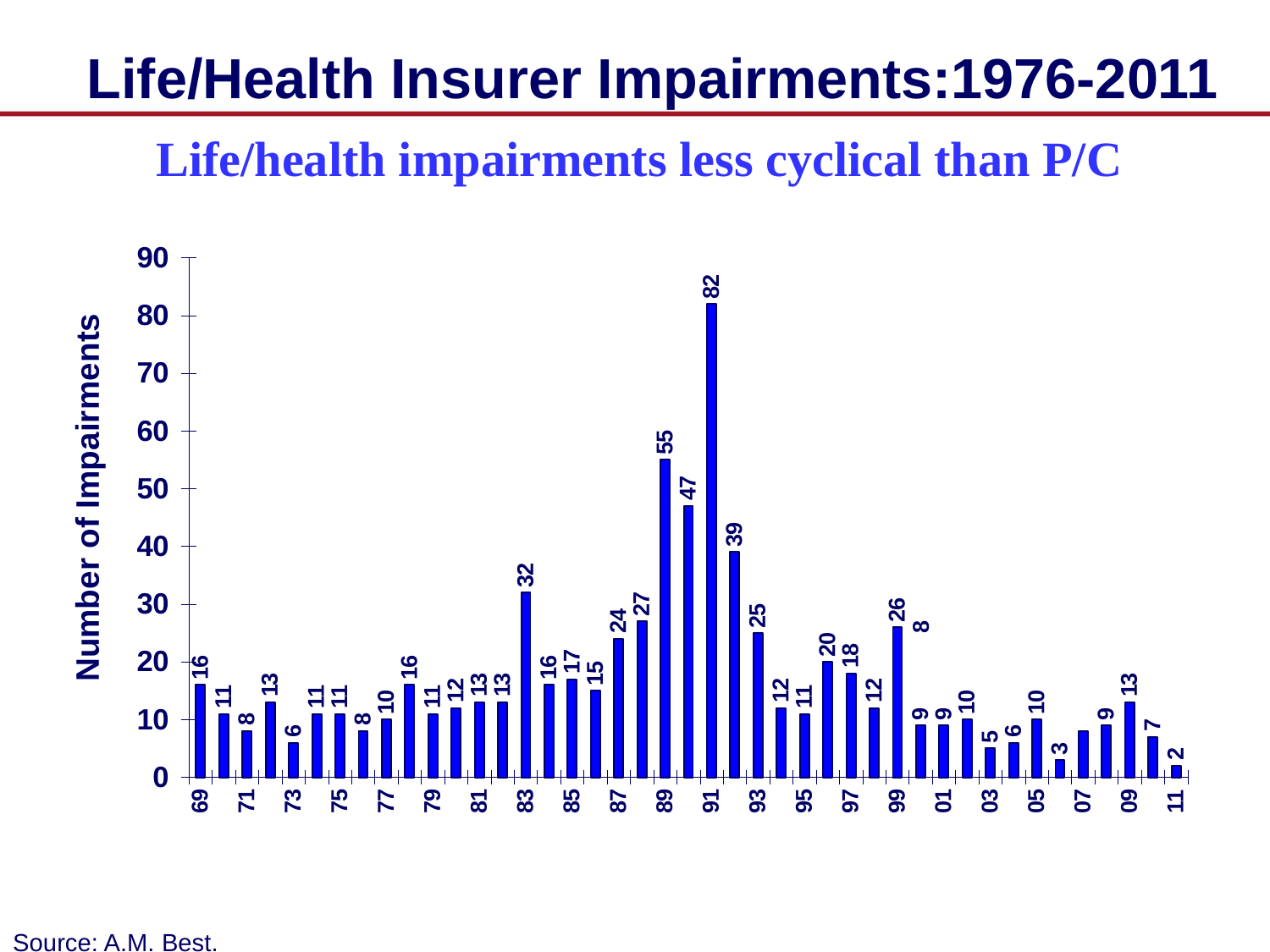
What is the label on the vertical axis? Number of Impairments What is the number of impairments for 73? 6 Which year has the highest number of impairments? 91 What kind of chart is shown on the slide? bar chart What is the number of impairments for 99? 26 What is the difference between the number of impairments in 91 and in 89? 27 Is the value for 87 greater or less than 20? greater What is the source cited at the bottom of the slide? A.M. Best. What is the number of impairments for 91? 82 What is the number of impairments for 83? 32 Which year has more impairments, 89 or 93? 89 What is the number of impairments for 89? 55